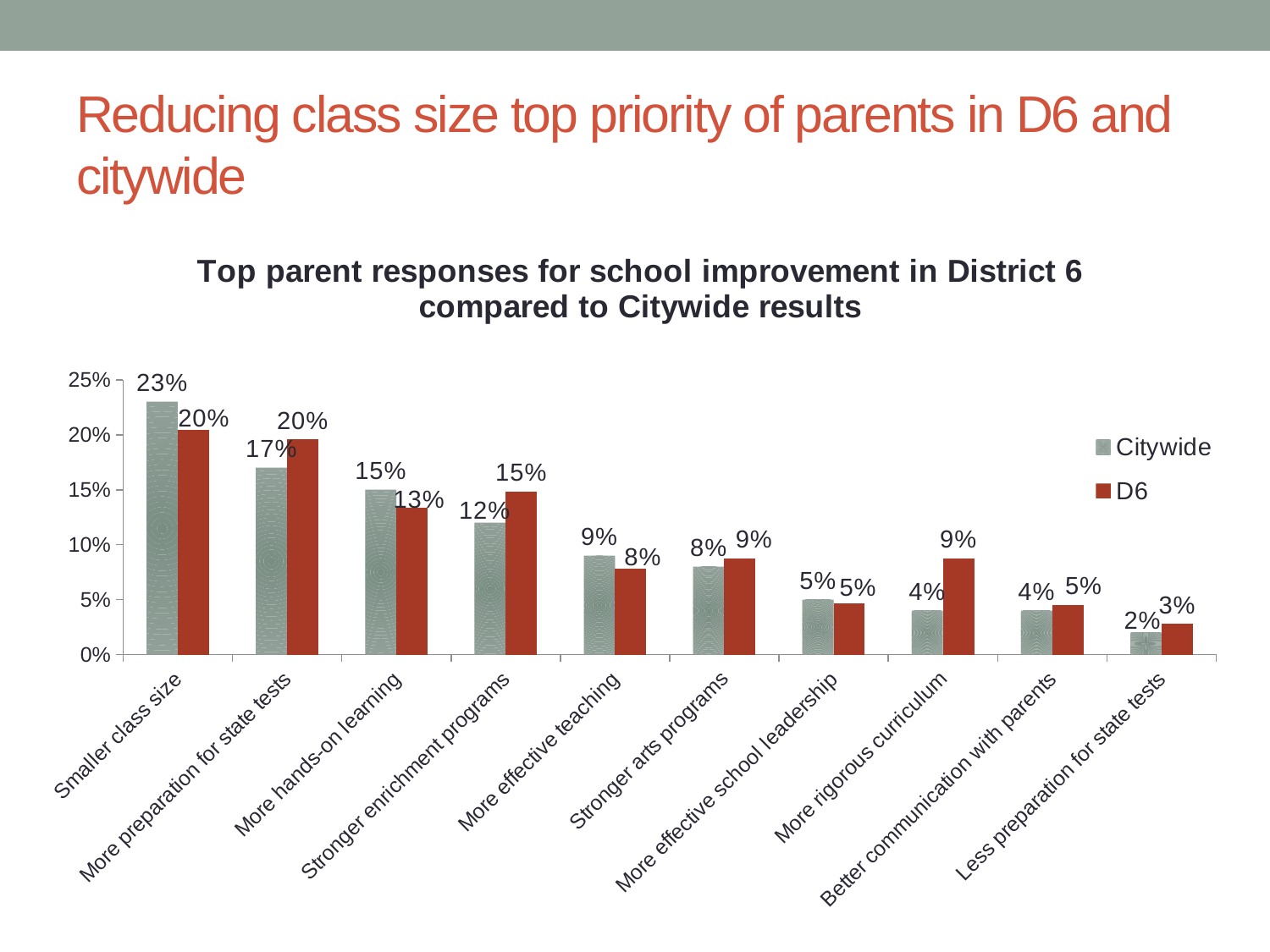
What is the difference between the Citywide and D6 values for More rigorous curriculum? 5% What is the title of the chart? Top parent responses for school improvement in District 6 compared to Citywide results What is the D6 value for More rigorous curriculum? 9% How many series does the legend list? 2 Which is larger for More hands-on learning, the Citywide value or the D6 value? Citywide What is the Citywide value for Stronger enrichment programs? 12% What is the Citywide value for Smaller class size? 23% How many categories are shown on the x axis? 10 What kind of chart is shown on the slide? Bar chart Which category has the highest Citywide value? Smaller class size Which category has the lowest D6 value? Less preparation for state tests Is the D6 value for More preparation for state tests greater or less than 15%? greater